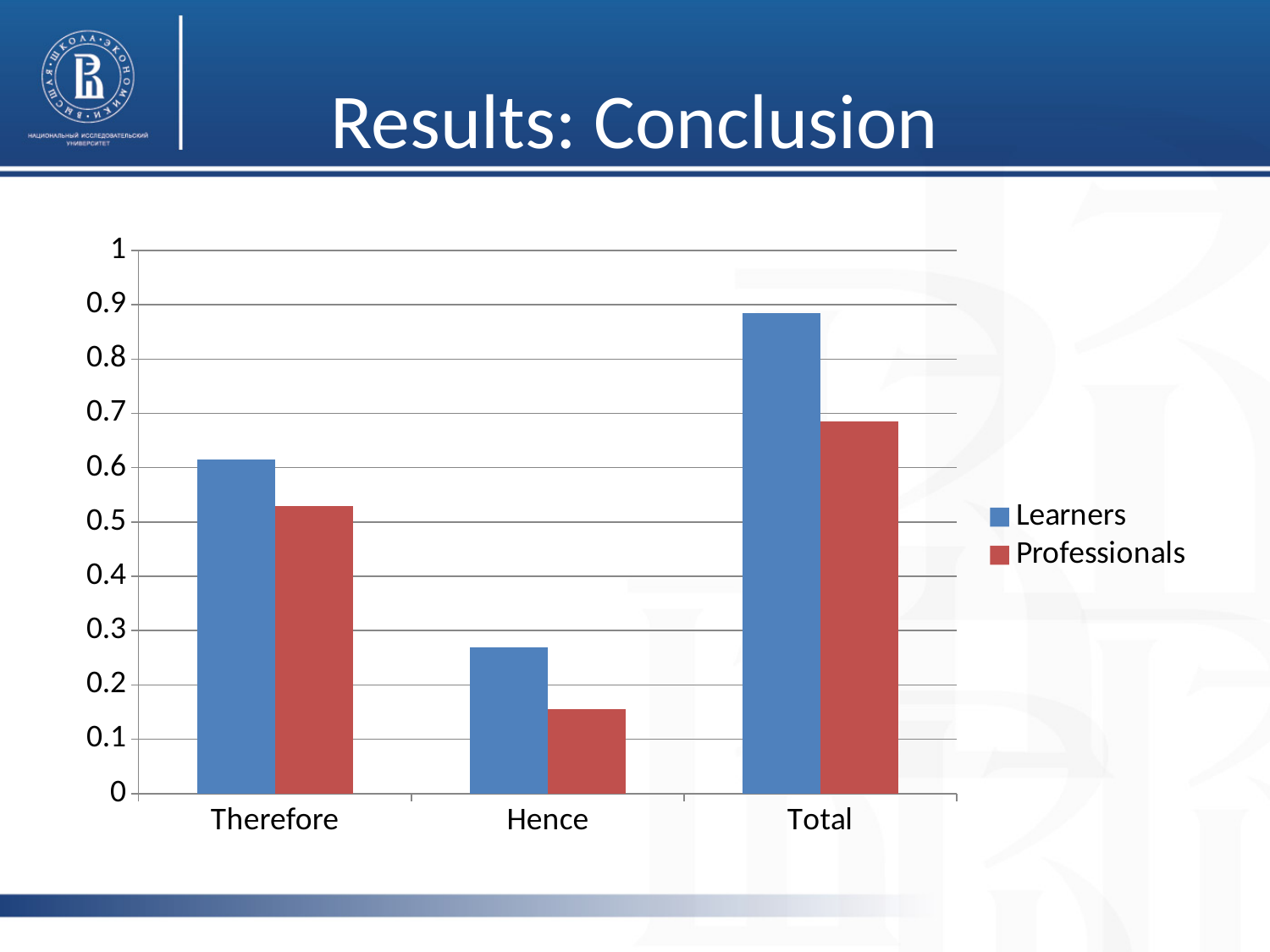
Which category has the highest value for Learners? Total How many categories are shown on the x axis? 3 What colour represents the Professionals series in the chart? red What kind of chart is shown on the slide? bar chart How many series does the legend list? 2 Which category has the lowest value for Professionals? Hence For the Therefore category, which series has the larger value, Learners or Professionals? Learners Is the value for Learners in the Total category greater or less than 0.8? greater Is the value for Professionals in the Hence category greater or less than 0.2? less Is the value for Learners in the Hence category greater or less than 0.3? less For the Total category, which series has the larger value, Learners or Professionals? Learners